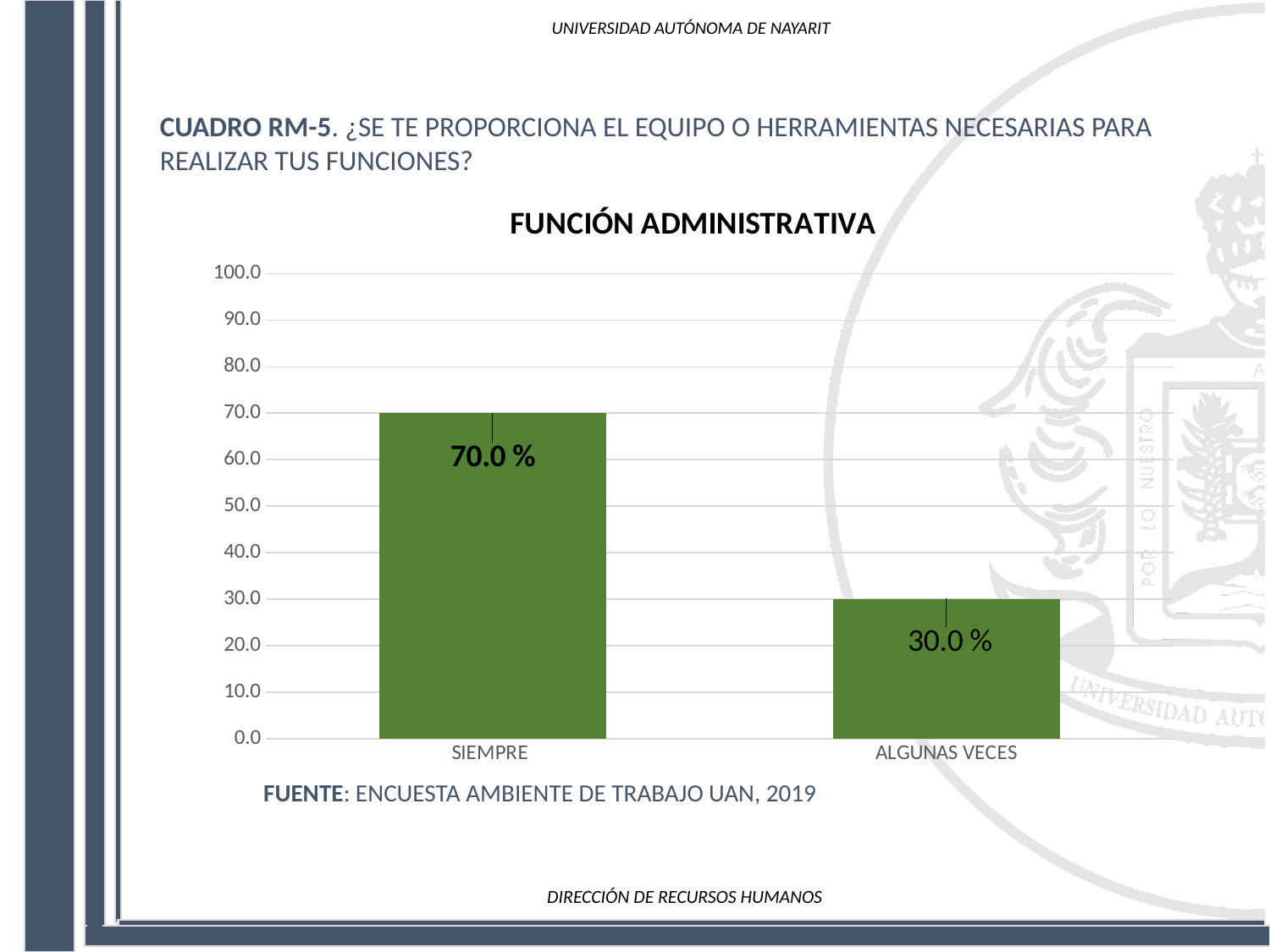
What kind of chart is shown on the slide? bar chart What is the value for ALGUNAS VECES? 30.0 % Is the value for ALGUNAS VECES greater or less than 50.0? less How many categories are shown on the x axis? 2 What is the difference between the values for SIEMPRE and ALGUNAS VECES? 40.0 % Which category has the highest value? SIEMPRE Which category has the lowest value? ALGUNAS VECES What is the highest value shown on the y axis? 100.0 Is the value for SIEMPRE greater or less than 60.0? greater What is the value for SIEMPRE? 70.0 % Which is larger, the value for SIEMPRE or the value for ALGUNAS VECES? SIEMPRE What is the title of the chart? FUNCIÓN ADMINISTRATIVA